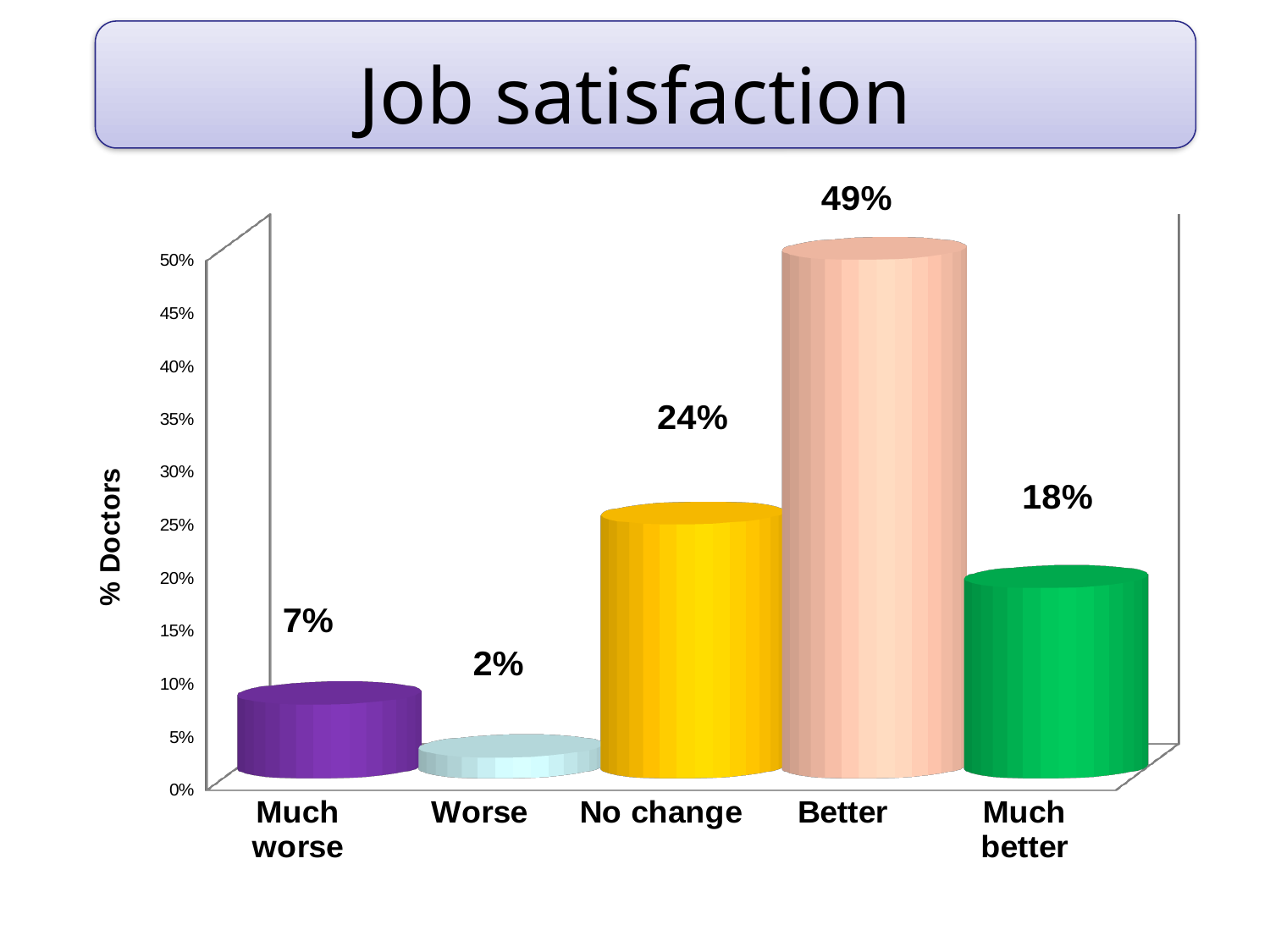
Which category has the lowest value? Worse What percentage of doctors reported 'Much worse'? 7% What is the difference between the values for 'Better' and 'No change'? 25% Is the value for 'No change' greater or less than 20%? greater What kind of chart is shown on the slide? Bar chart Which category has the highest value? Better What percentage of doctors reported 'Better' job satisfaction? 49% What is the label on the vertical axis? % Doctors What is the value for 'Much better'? 18% How many categories are shown on the x axis? 5 What is the value for 'No change'? 24% Which is larger, the value for 'Much better' or the value for 'Much worse'? Much better